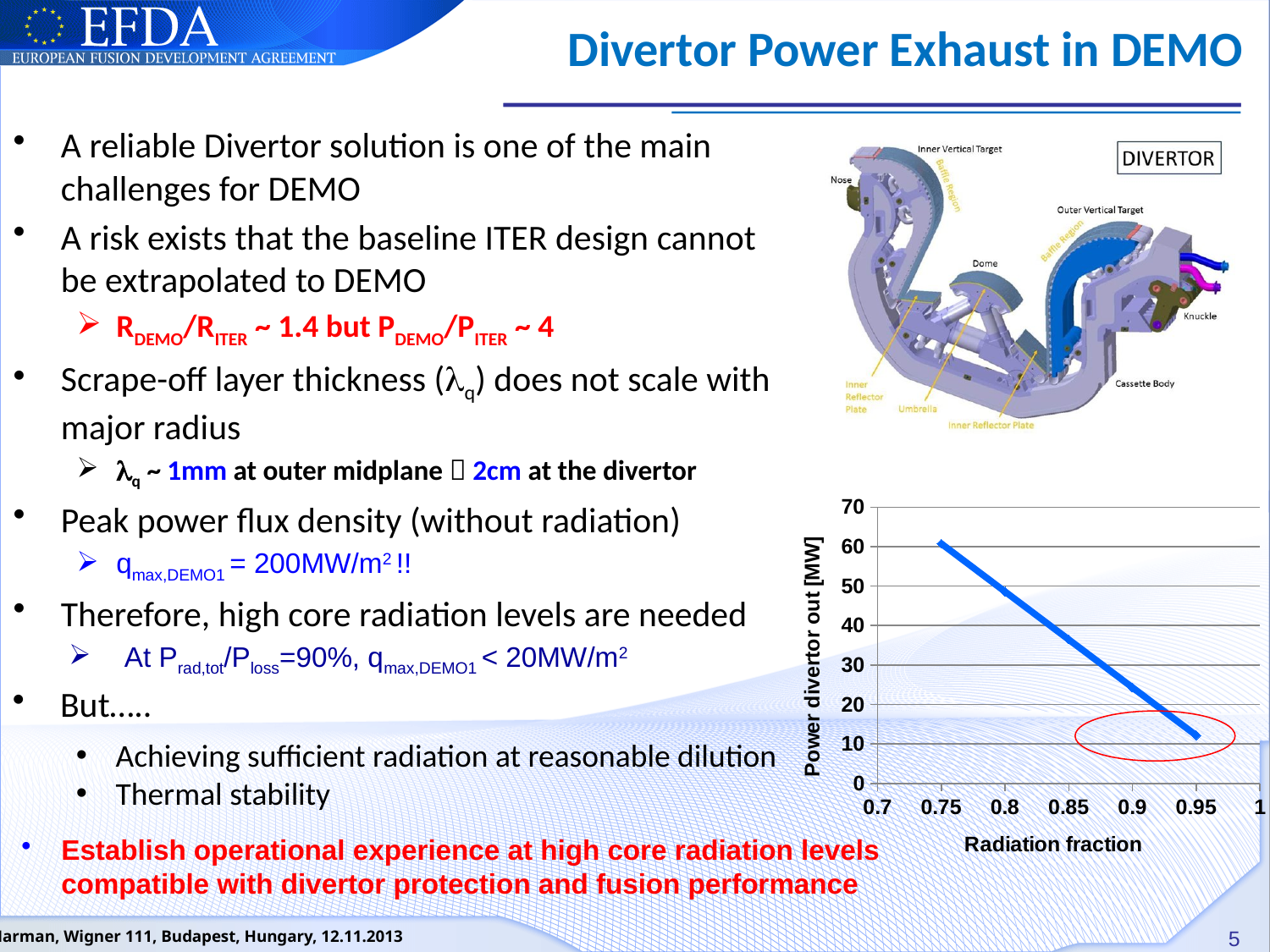
In the chart at the bottom right, does the power divertor out rise or fall as the radiation fraction increases? fall What kind of chart is shown at the bottom right of the slide? line chart In the chart at the bottom right, is the power divertor out at a radiation fraction of 0.8 greater or less than 40? greater In the chart at the bottom right, what is the label of the y axis? Power divertor out [MW] In the chart at the bottom right, is the power divertor out at a radiation fraction of 0.75 greater or less than 50? greater In the chart at the bottom right, what is the label of the x axis? Radiation fraction In the chart at the bottom right, is the power divertor out at a radiation fraction of 0.85 greater or less than 30? greater In the chart at the bottom right, at which radiation fraction shown on the line is the power divertor out lowest? 0.95 In the chart at the bottom right, which has the higher power divertor out: a radiation fraction of 0.75 or 0.95? 0.75